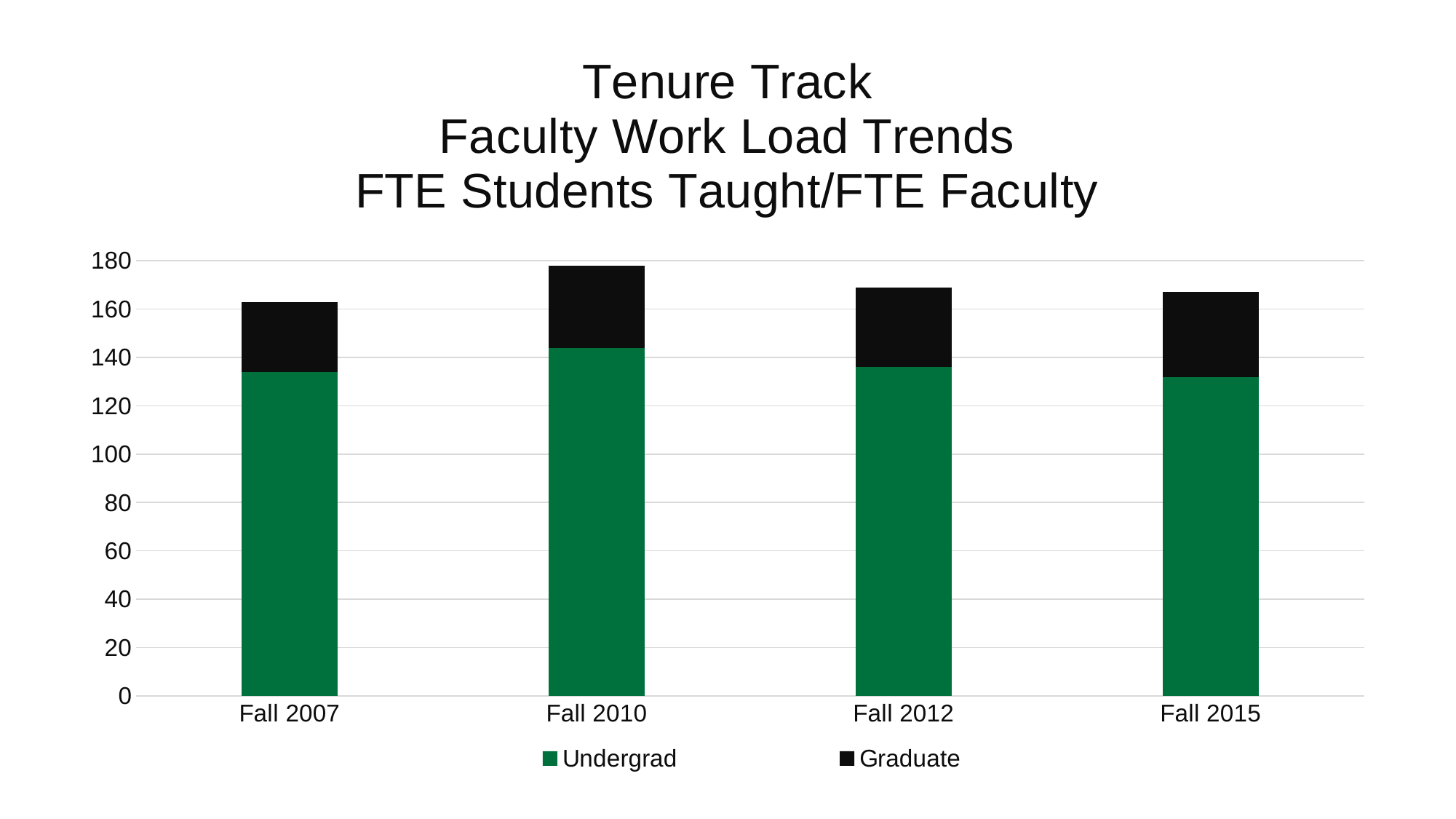
Is the Undergrad value for Fall 2015 greater or less than 140? less How many series does the legend list? 2 Which category has the highest Undergrad value? Fall 2010 Is the Undergrad value for Fall 2007 greater or less than 140? less Which series is shown in green? Undergrad Which category has the tallest stacked bar overall? Fall 2010 Does the total stacked bar rise or fall from Fall 2007 to Fall 2010? rise Which is larger, the total stacked bar for Fall 2010 or for Fall 2007? Fall 2010 How many categories are shown on the x axis? 4 Is the total stacked bar for Fall 2012 greater or less than 160? greater What kind of chart is shown on the slide? Stacked bar chart